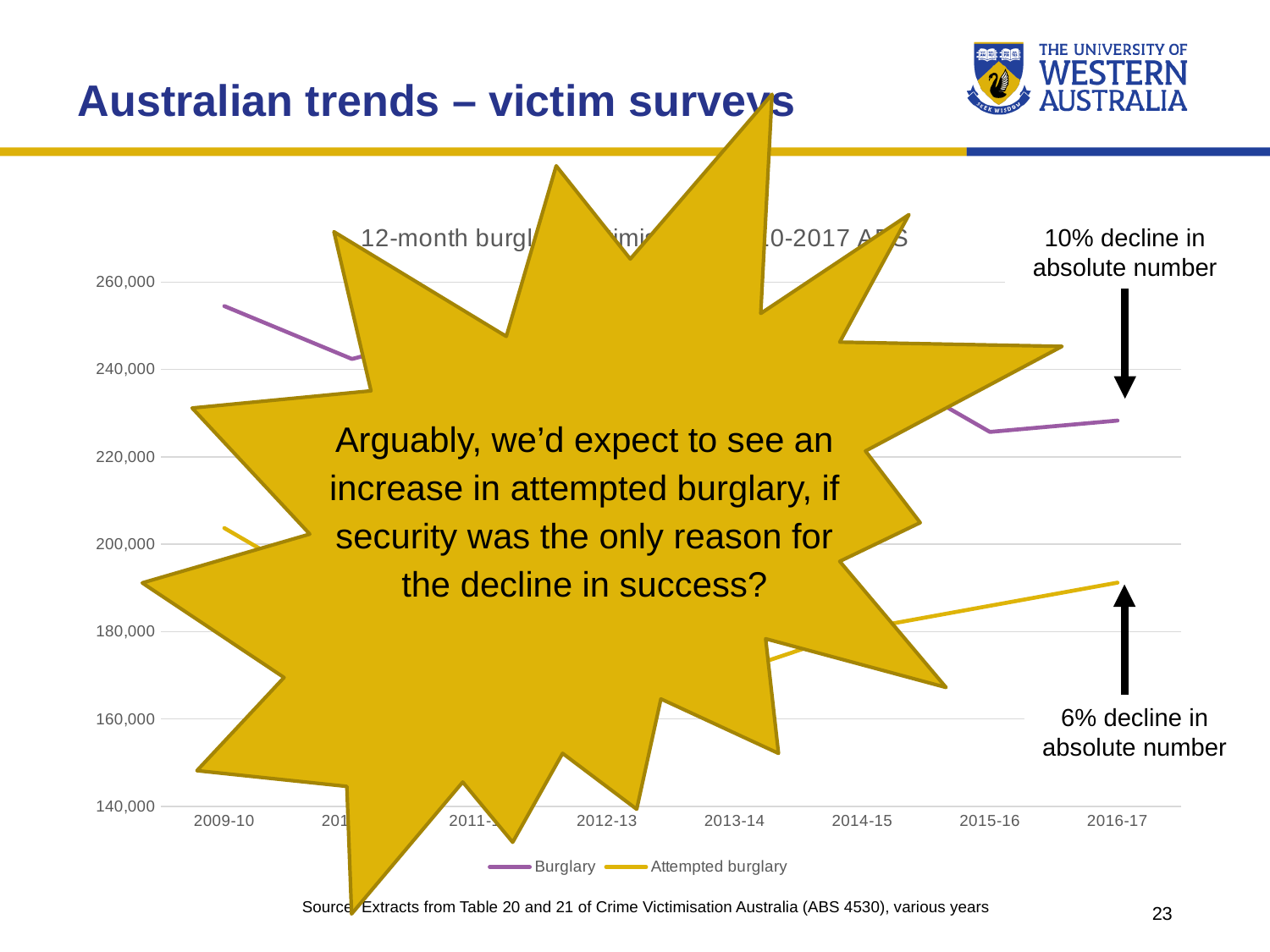
How many series does the chart legend list? 2 What colour is the Attempted burglary line in the chart? yellow What kind of chart is shown on the slide? line chart Does the Burglary line rise or fall between 2009-10 and 2016-17? fall What are the two series named in the chart legend? Burglary and Attempted burglary How many year categories are shown on the x axis of the chart? 8 Is the Burglary value for 2009-10 greater or less than 260,000? less Is the Burglary value for 2009-10 greater or less than 240,000? greater In 2016-17, which series has the higher value, Burglary or Attempted burglary? Burglary Is the Burglary value for 2016-17 greater or less than 240,000? less